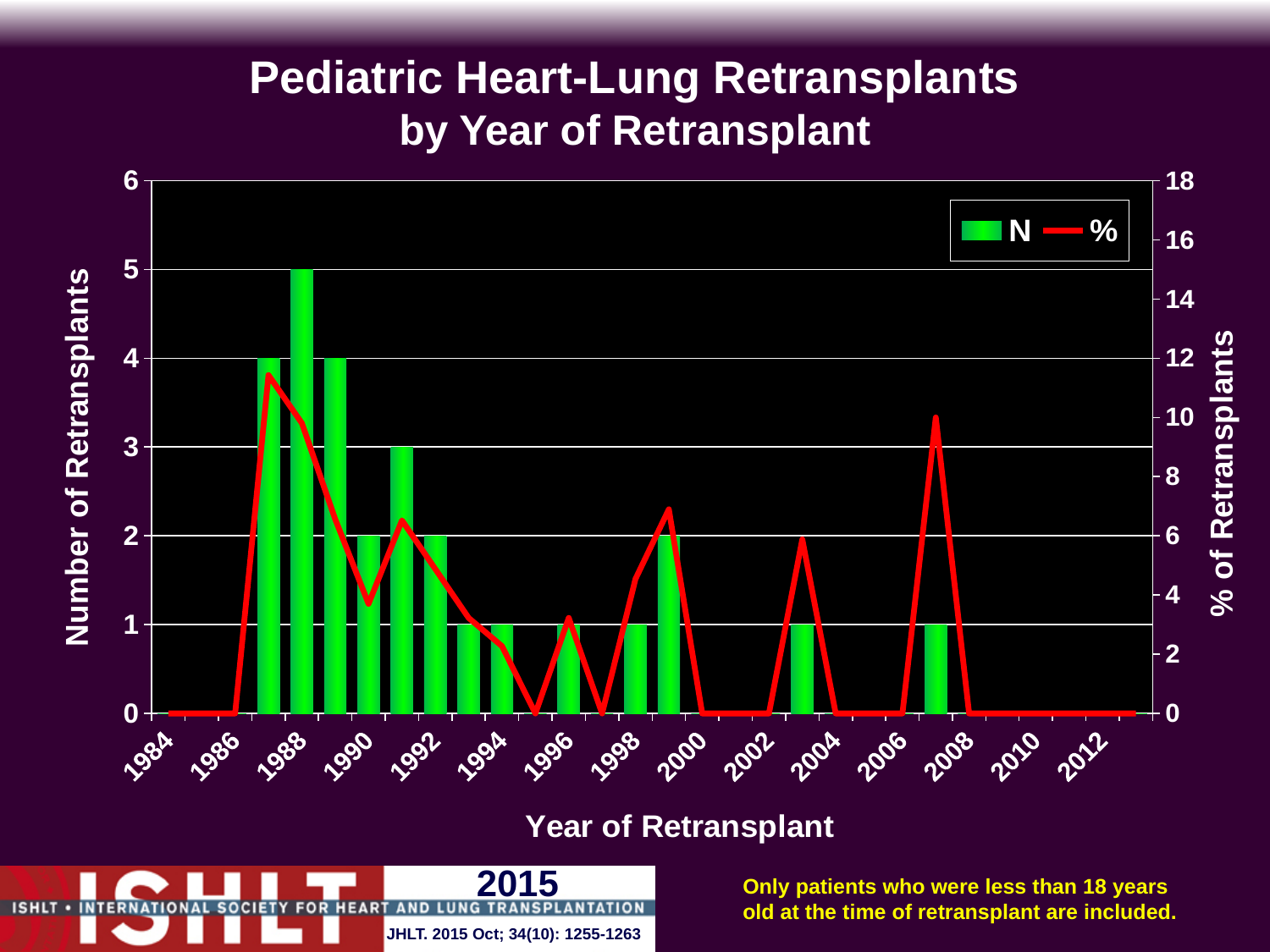
What kind of chart is used to show the N series? Bar chart Do the number of retransplants rise or fall from 1988 to 1990? Fall What is the number of retransplants (N) in 1999? 2 What is the title of the right-hand vertical axis? % of Retransplants Which year has the highest number of retransplants? 1988 What are the two entries in the legend? N and % What is the difference in number of retransplants between 1988 and 1991? 2 What is the number of retransplants (N) in 1991? 3 What is the number of retransplants (N) in 1988? 5 Is the % of retransplants value for 2007 greater or less than 8? greater How many series does the legend list? 2 Which year has more retransplants, 1987 or 1990? 1987